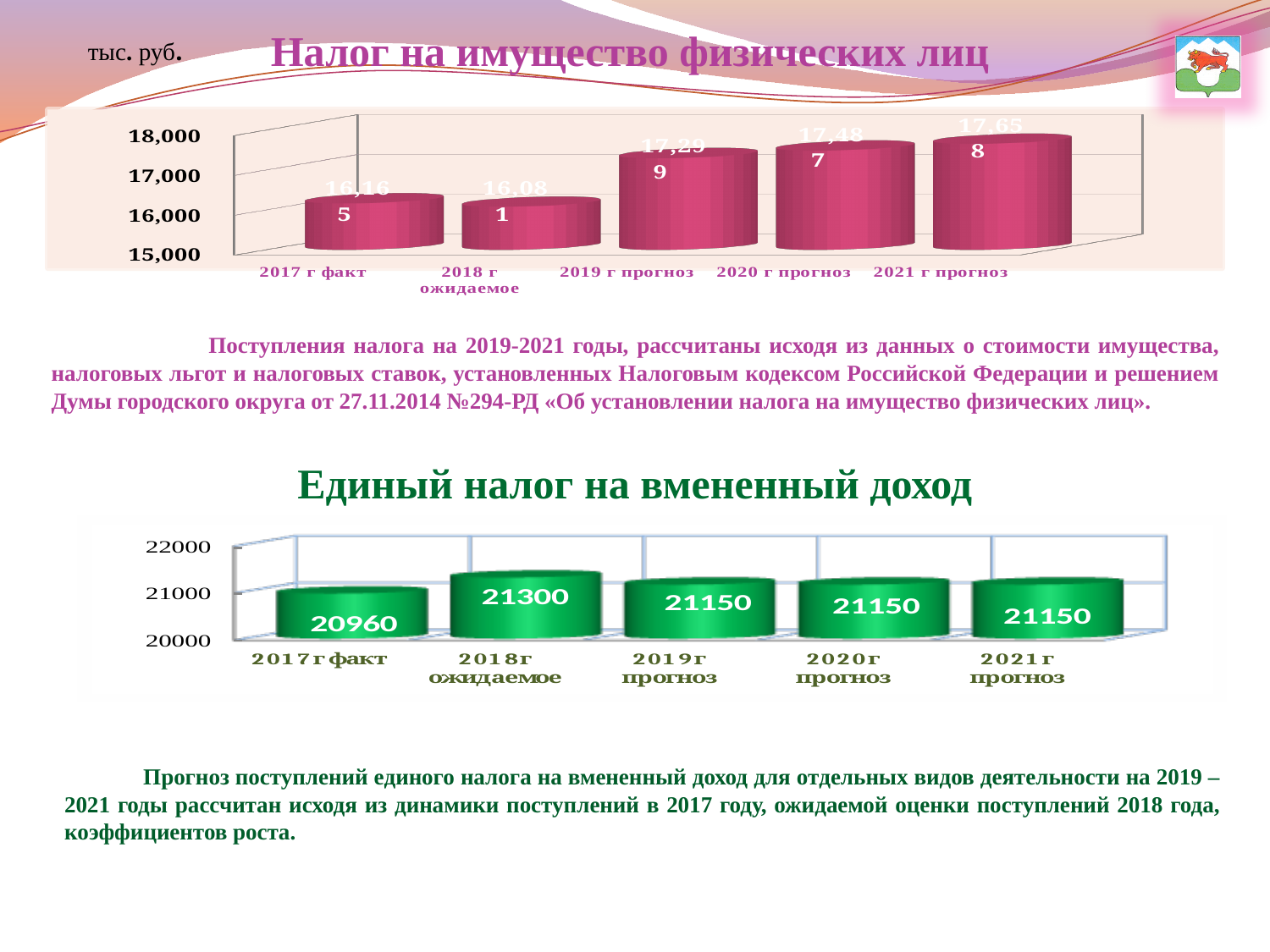
In the chart titled 'Единый налог на вмененный доход', what is the value for '2017 г факт'? 20960 In the chart titled 'Налог на имущество физических лиц', which is larger, the value for '2019 г прогноз' or '2018 г ожидаемое'? 2019 г прогноз In the chart titled 'Налог на имущество физических лиц', how many bars are shown? 5 In the chart titled 'Единый налог на вмененный доход', which category has the lowest value? 2017 г факт In the chart titled 'Единый налог на вмененный доход', which category has the highest value? 2018 г ожидаемое In the chart titled 'Налог на имущество физических лиц', is the value for '2017 г факт' greater or less than 17,000? less In the chart titled 'Единый налог на вмененный доход', how many categories are shown on the x axis? 5 In the chart titled 'Единый налог на вмененный доход', what is the difference between the values for '2018 г ожидаемое' and '2017 г факт'? 340 In the chart titled 'Единый налог на вмененный доход', what is the value for '2018 г ожидаемое'? 21300 In the chart titled 'Налог на имущество физических лиц', is the value for '2021 г прогноз' greater or less than 17,000? greater In the chart titled 'Единый налог на вмененный доход', what is the value for '2021 г прогноз'? 21150 What kind of chart is the chart titled 'Единый налог на вмененный доход'? bar chart